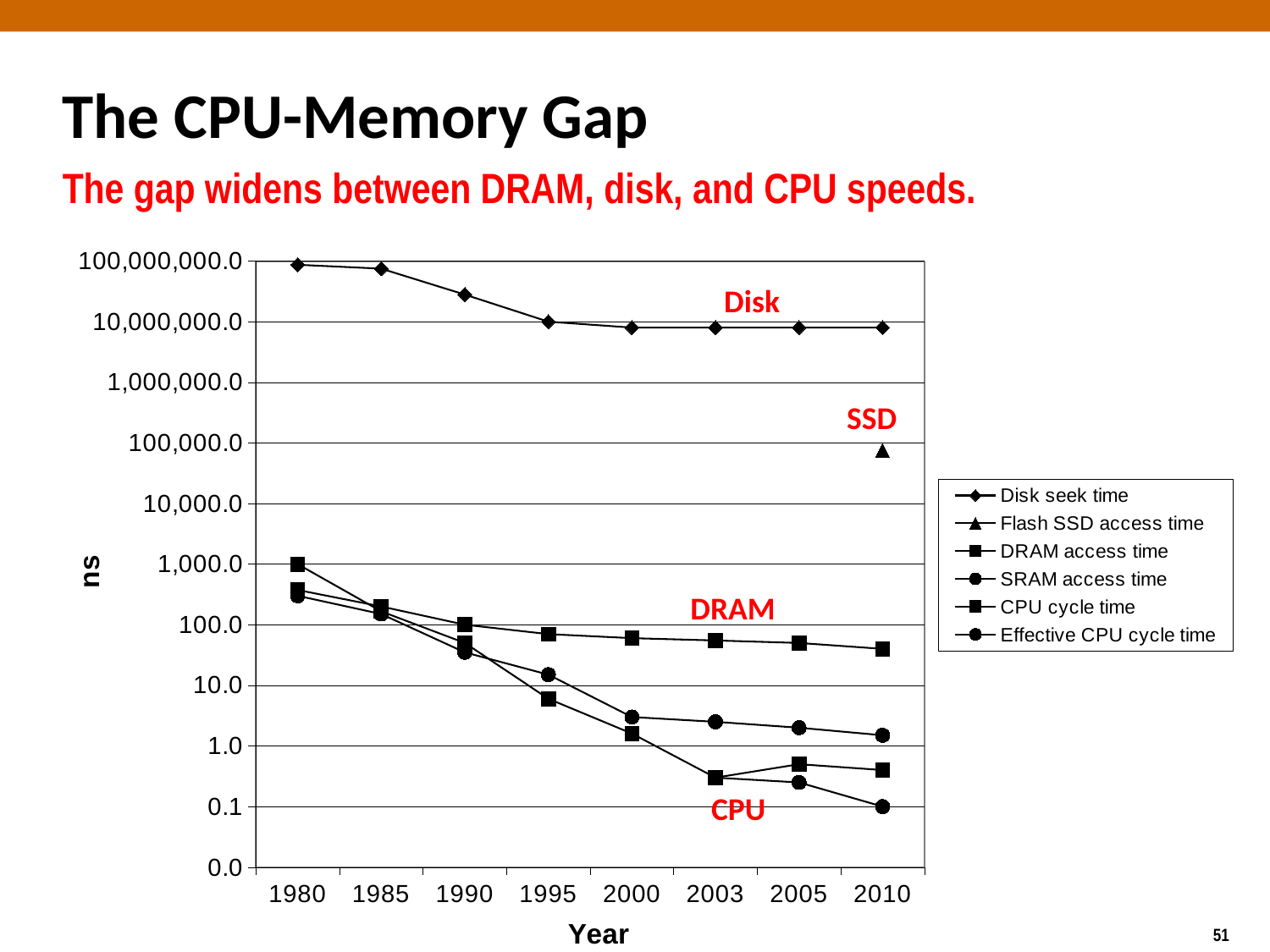
In 2010, which is larger: the Disk seek time or the DRAM access time? Disk seek time Does the Disk seek time rise or fall from 1980 to 2010? fall What is the label on the y axis of the chart? ns Is the DRAM access time in 2010 greater or less than 100.0? less Does the DRAM access time rise or fall from 1980 to 2010? fall What kind of chart is shown on the slide? line chart How many years are marked along the x axis? 8 Is the Effective CPU cycle time in 2010 greater or less than 1.0? less In 2010, which is larger: the DRAM access time or the SRAM access time? DRAM access time How many series does the legend list? 6 Is the Disk seek time in 1980 greater or less than 10,000,000.0? greater